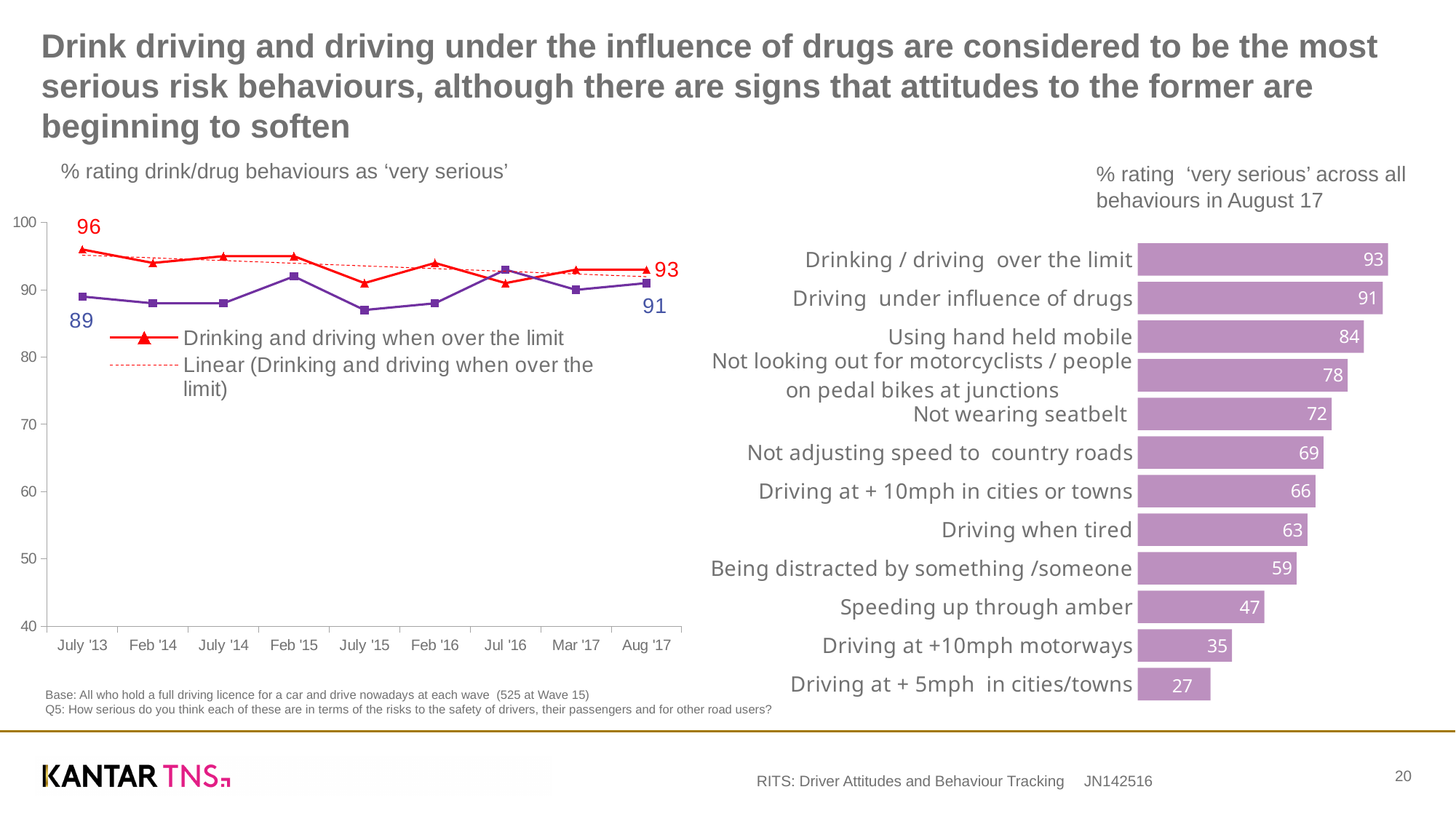
What kind of chart is the left chart? line chart How many behaviours are listed in the right chart? 12 In the left chart, by how much did the 'Drinking and driving when over the limit' value fall between July '13 and Aug '17? 3 In the right chart, which behaviour has the highest percentage rating 'very serious'? Drinking / driving over the limit In the right chart, what is the difference between 'Not wearing seatbelt' and 'Speeding up through amber'? 25 What kind of chart is the right chart? bar chart In the left chart, what is the value for 'Drinking and driving when over the limit' in July '13? 96 In the right chart, which behaviour has the lowest percentage rating 'very serious'? Driving at + 5mph in cities/towns In the right chart, what is the value for 'Using hand held mobile'? 84 In the left chart, how many time points are shown on the x axis? 9 In the left chart, what is the value for 'Drinking and driving when over the limit' in Aug '17? 93 In the right chart, which is larger: 'Driving when tired' or 'Driving at +10mph motorways'? Driving when tired